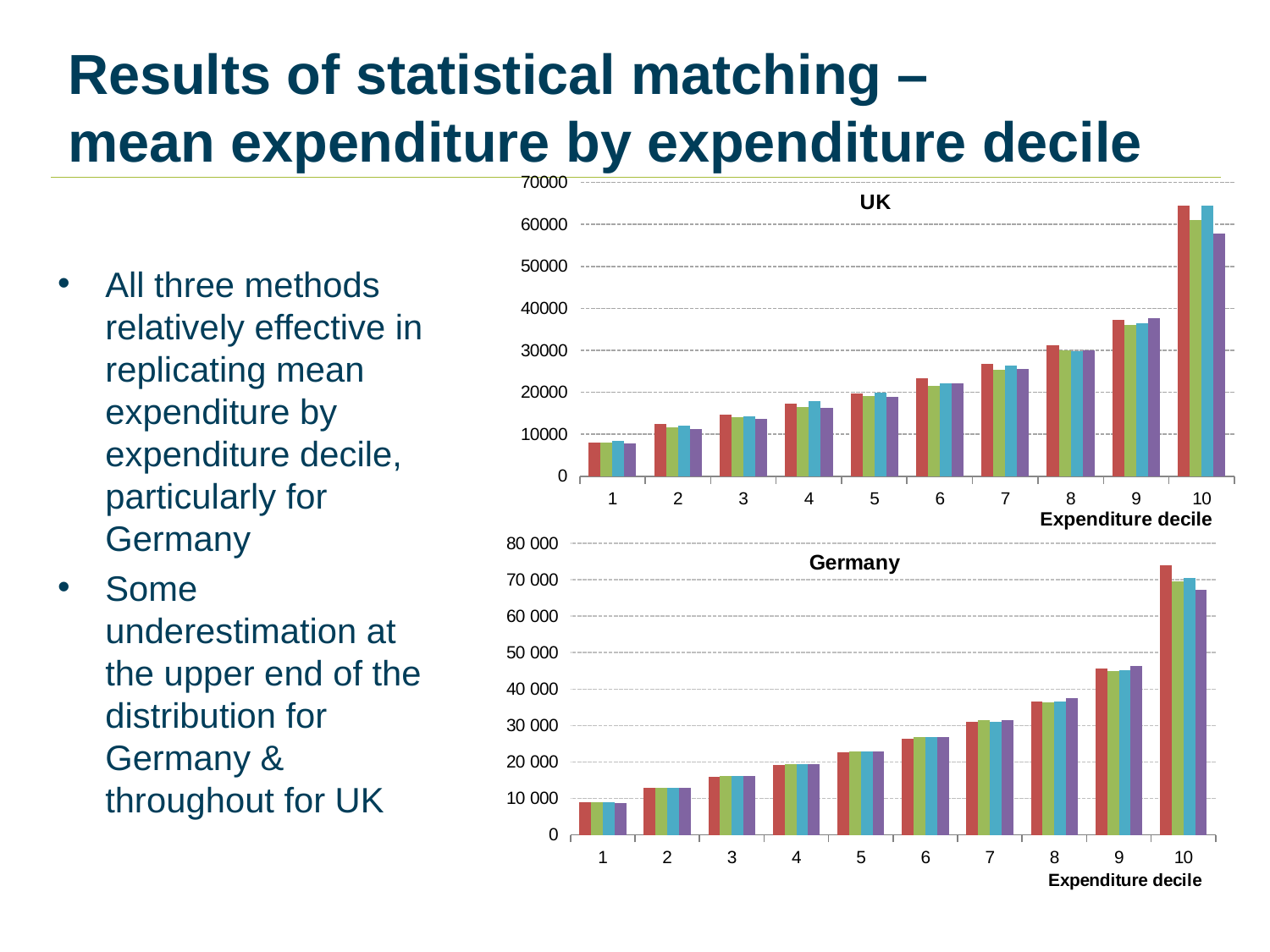
In the UK chart, do the values rise or fall as the expenditure decile increases from 1 to 10? rise In the Germany chart, which expenditure decile has the highest mean expenditure? 10 What is the label on the x axis of the Germany chart? Expenditure decile In the UK chart, which expenditure decile has the lowest mean expenditure? 1 What kind of chart is the UK chart at the top of the slide? bar chart In the UK chart, how many bars are plotted for each expenditure decile? 4 In the Germany chart, are the values for decile 1 greater or less than 10 000? less In the Germany chart, which has the larger mean expenditure, decile 3 or decile 6? decile 6 In the Germany chart, are the values for decile 9 greater or less than 50 000? less In the UK chart, are the values for decile 7 greater or less than 20000? greater How many expenditure deciles are shown on the x axis of the Germany chart? 10